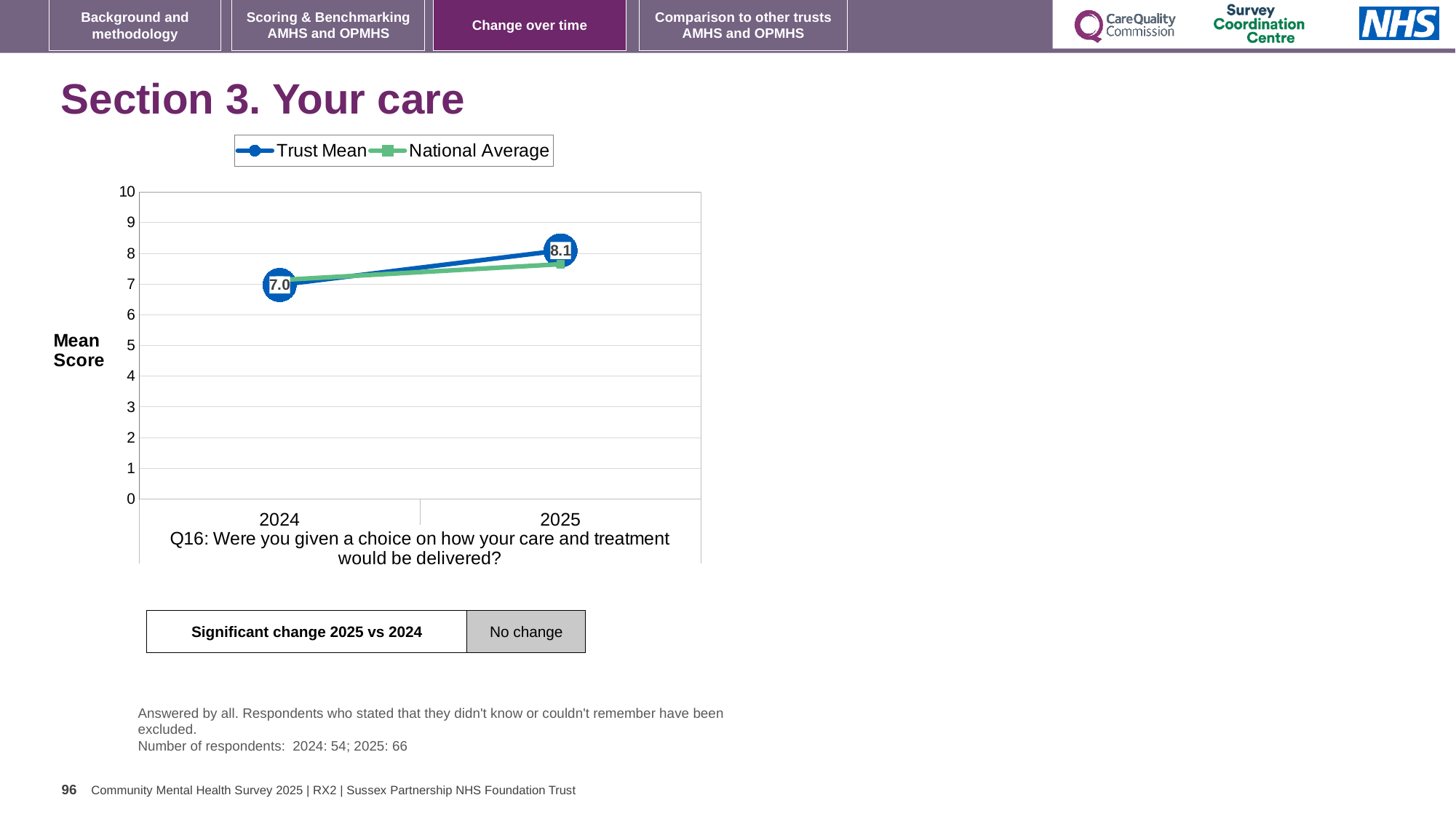
What is the label on the y axis of the chart? Mean Score What kind of chart is shown on the slide? line chart How many years are plotted on the x axis? 2 By how much did the Trust Mean score change from 2024 to 2025? 1.1 What is the Trust Mean score for 2025? 8.1 Is the National Average value for 2025 greater or less than 7? greater What is the Trust Mean score for 2024? 7.0 Does the Trust Mean rise or fall from 2024 to 2025? rise How many series does the legend list? 2 In which year is the Trust Mean score higher? 2025 Is the National Average value for 2024 greater or less than 8? less In 2025, which is larger: the Trust Mean or the National Average? Trust Mean